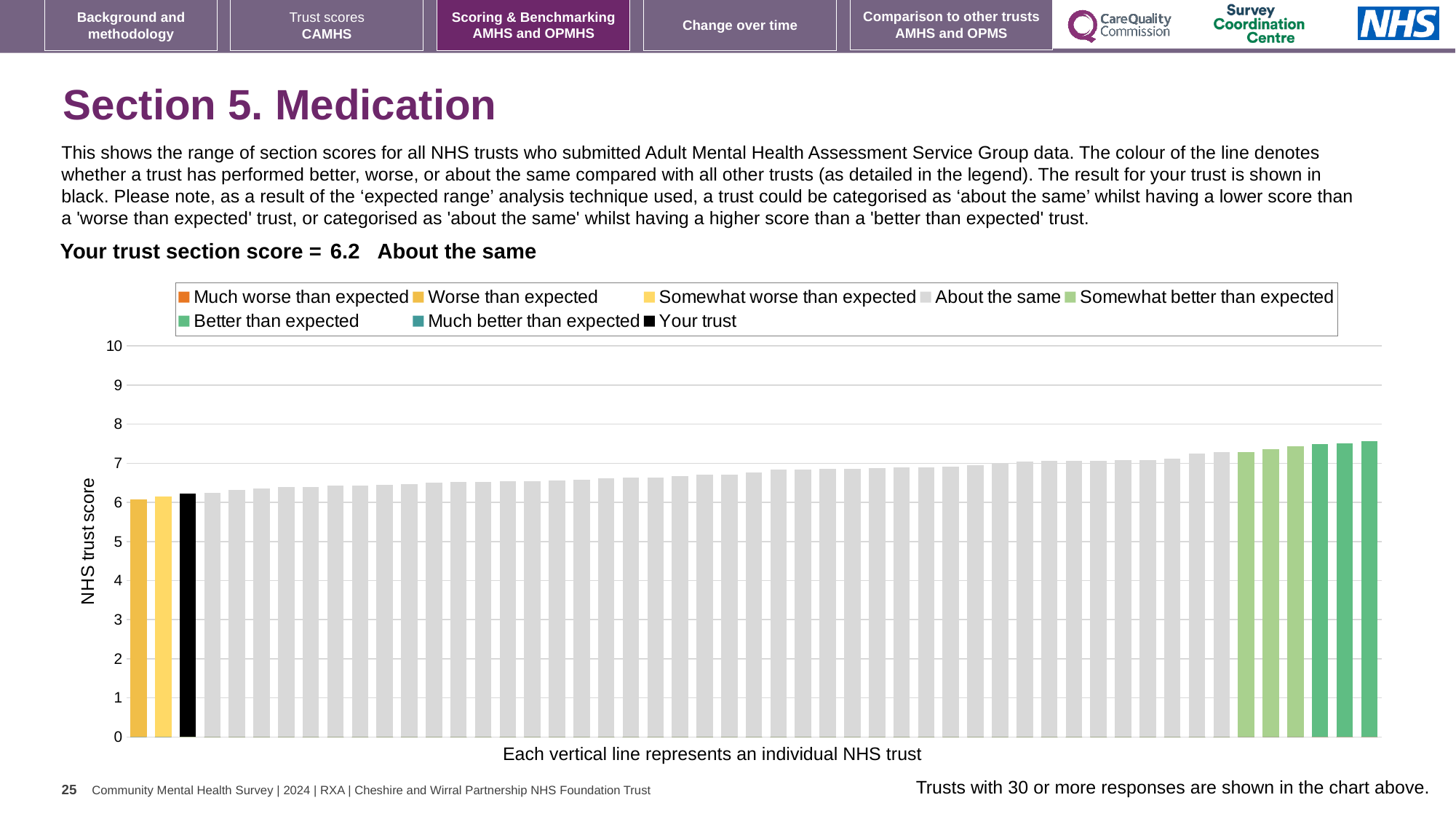
What is the highest value shown on the vertical axis? 10 Which is larger, the leftmost bar or the rightmost bar? the rightmost bar What is the section score for your trust? 6.2 Is the value of the black 'Your trust' bar greater or less than 5? greater What is the label on the vertical axis of the chart? NHS trust score What kind of chart is shown on the slide? bar chart Which category is your trust's section score placed in? About the same Do the bar values rise or fall from left to right along the x axis? rise Is the value of the leftmost bar in the chart greater or less than 7? less How many entries does the chart legend list? 8 Is the value of the tallest bar in the chart greater or less than 7? greater What colour is the bar representing your trust? black